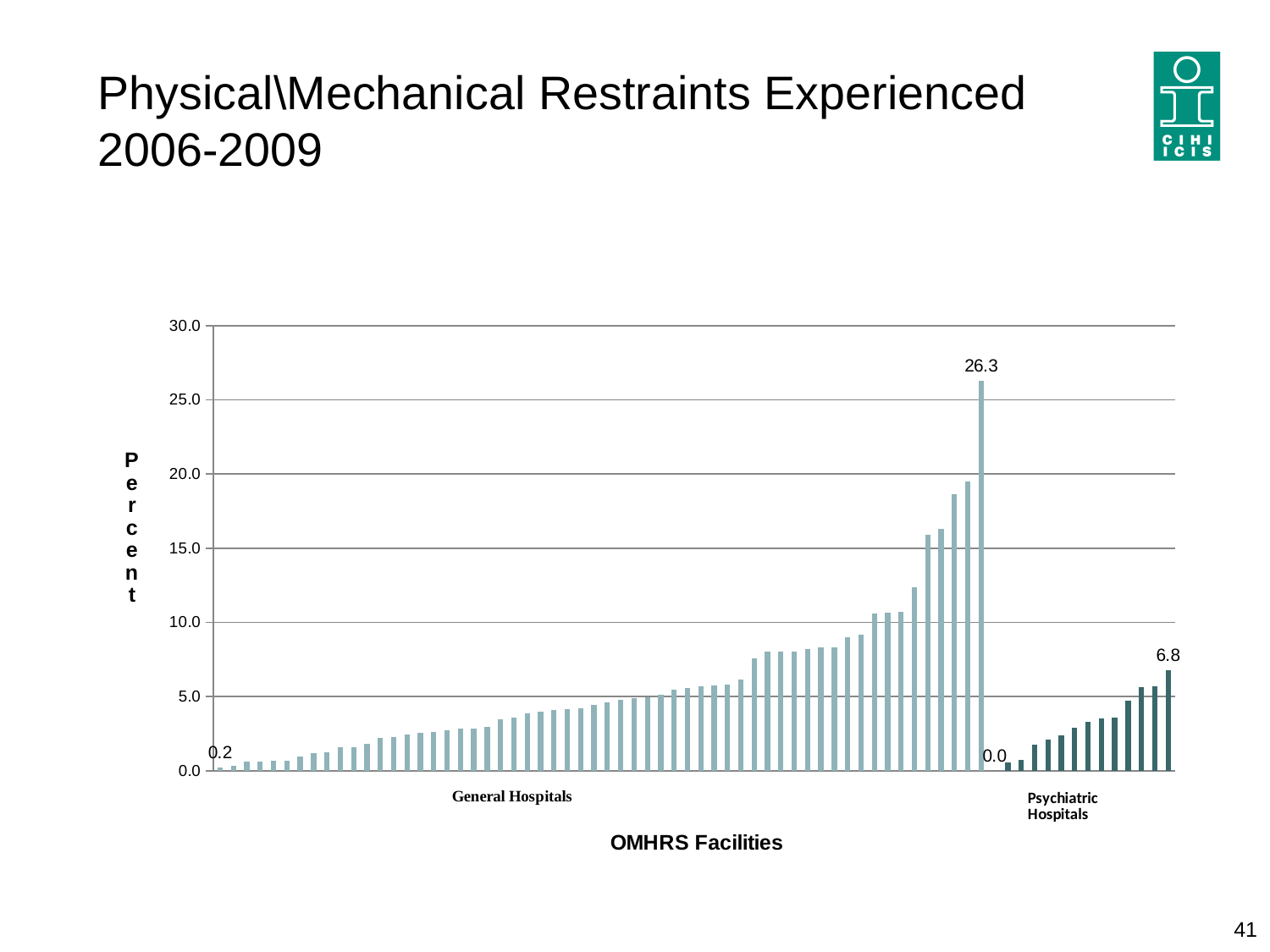
What is the value of the tallest bar in the Psychiatric Hospitals group? 6.8 Which group has the taller maximum bar, General Hospitals or Psychiatric Hospitals? General Hospitals Is the tallest Psychiatric Hospitals bar greater or less than 10.0? less What is the difference between the highest and lowest General Hospitals values? 26.1 What kind of chart is shown on the slide? bar chart Within the General Hospitals group, do the bar values rise or fall from left to right? rise What is the highest value shown on the chart? 26.3 What is the value of the shortest bar in the Psychiatric Hospitals group? 0.0 What is the label on the x axis of the chart? OMHRS Facilities What is the value of the tallest bar in the General Hospitals group? 26.3 What is the difference between the highest General Hospitals value and the highest Psychiatric Hospitals value? 19.5 What is the value of the shortest bar in the General Hospitals group? 0.2